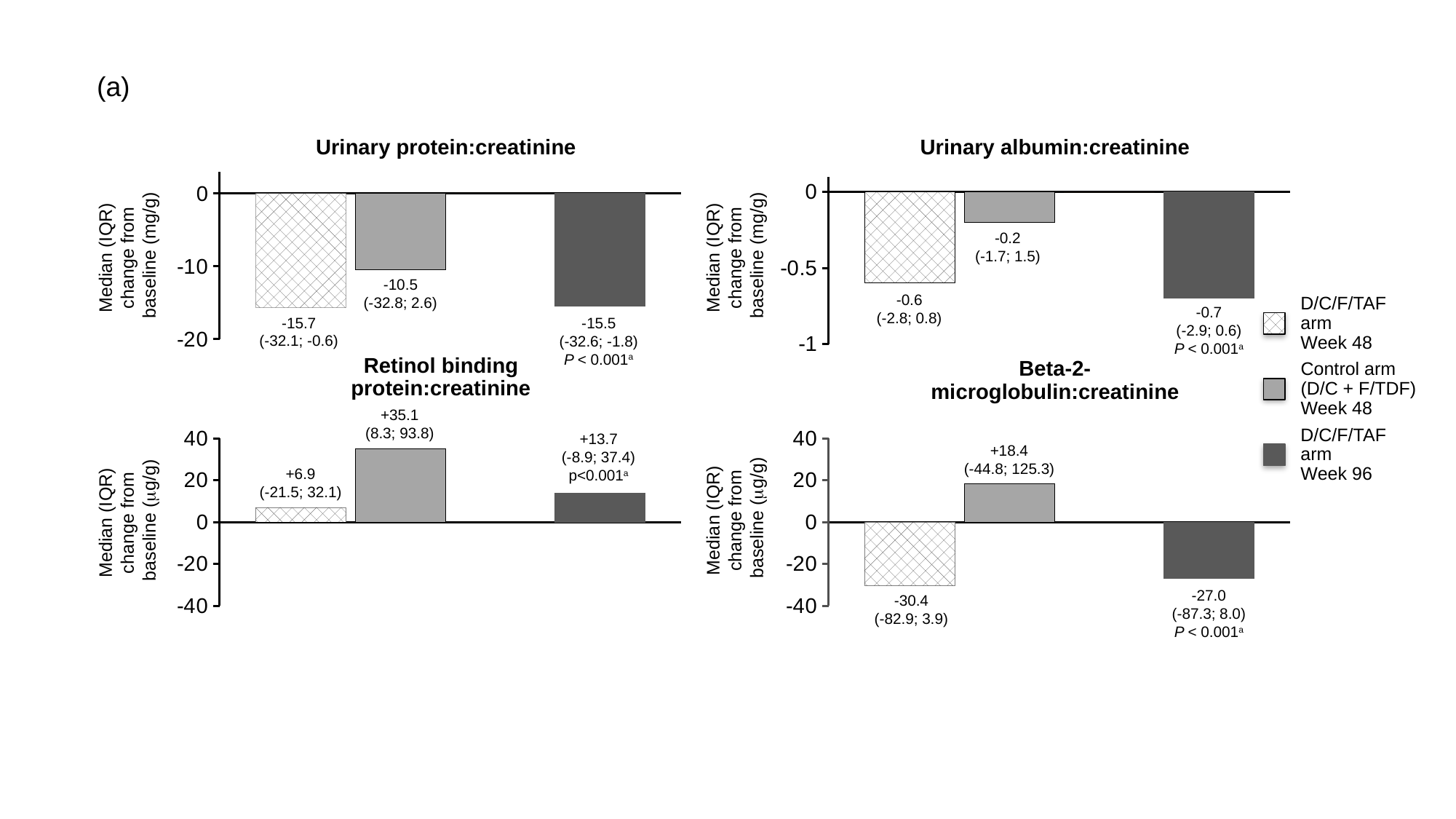
In the Urinary albumin:creatinine chart, is the median change for the D/C/F/TAF arm at Week 96 larger or smaller than for the Control arm at Week 48? smaller What type of chart is the Urinary albumin:creatinine chart? bar chart In the Retinol binding protein:creatinine chart, which arm has the highest median change from baseline? Control arm (D/C + F/TDF) Week 48 How many series does the legend list? 3 In the Urinary protein:creatinine chart, what is the median change from baseline for the D/C/F/TAF arm at Week 48? -15.7 In the Retinol binding protein:creatinine chart, what is the difference between the Control arm Week 48 value (+35.1) and the D/C/F/TAF arm Week 48 value (+6.9)? 28.2 How many bars are shown in the Urinary protein:creatinine chart? 3 In the Urinary albumin:creatinine chart, what is the median change from baseline for the Control arm (D/C + F/TDF) at Week 48? -0.2 In the Beta-2-microglobulin:creatinine chart, which arm has the lowest median change from baseline? D/C/F/TAF arm Week 48 In the Beta-2-microglobulin:creatinine chart, what is the median change from baseline for the D/C/F/TAF arm at Week 48? -30.4 In the Beta-2-microglobulin:creatinine chart, is the value for the Control arm Week 48 greater or less than 20? less In the Retinol binding protein:creatinine chart, what is the median change from baseline for the D/C/F/TAF arm at Week 96? +13.7